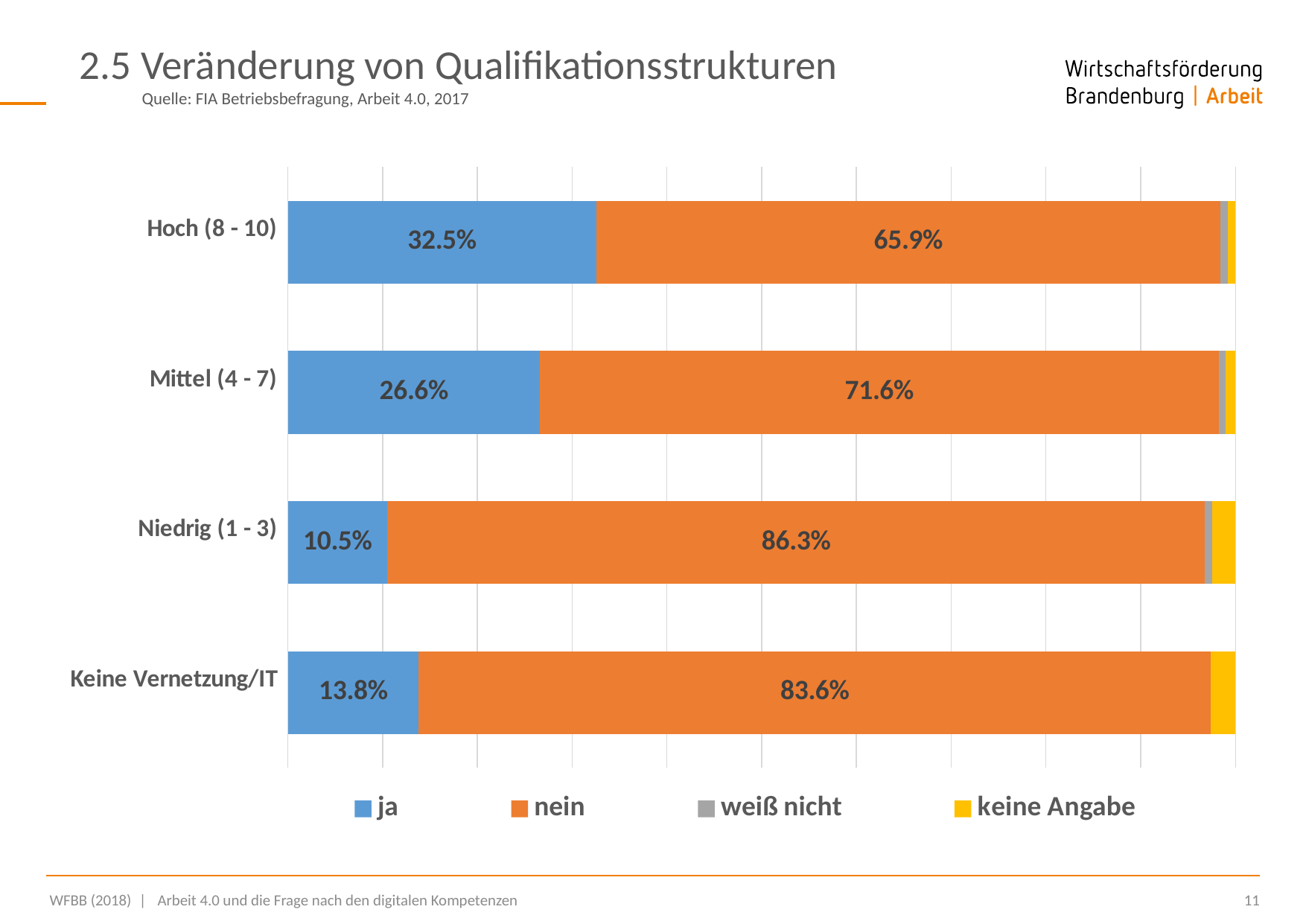
Which category has the lowest value for "nein"? Hoch (8 - 10) Which is larger: the "ja" value for Niedrig (1 - 3) or for Keine Vernetzung/IT? Keine Vernetzung/IT What is the value for "nein" in the Mittel (4 - 7) category? 71.6% How many categories are shown on the chart? 4 What is the value for "ja" in the Hoch (8 - 10) category? 32.5% Which category has the highest value for "ja"? Hoch (8 - 10) What is the difference between the "ja" values for Hoch (8 - 10) and Mittel (4 - 7)? 5.9% What kind of chart is shown on the slide? Stacked bar chart What is the value for "ja" in the Niedrig (1 - 3) category? 10.5% Which category has the highest value for "nein"? Niedrig (1 - 3) How many series does the legend list? 4 What is the value for "nein" in the Keine Vernetzung/IT category? 83.6%